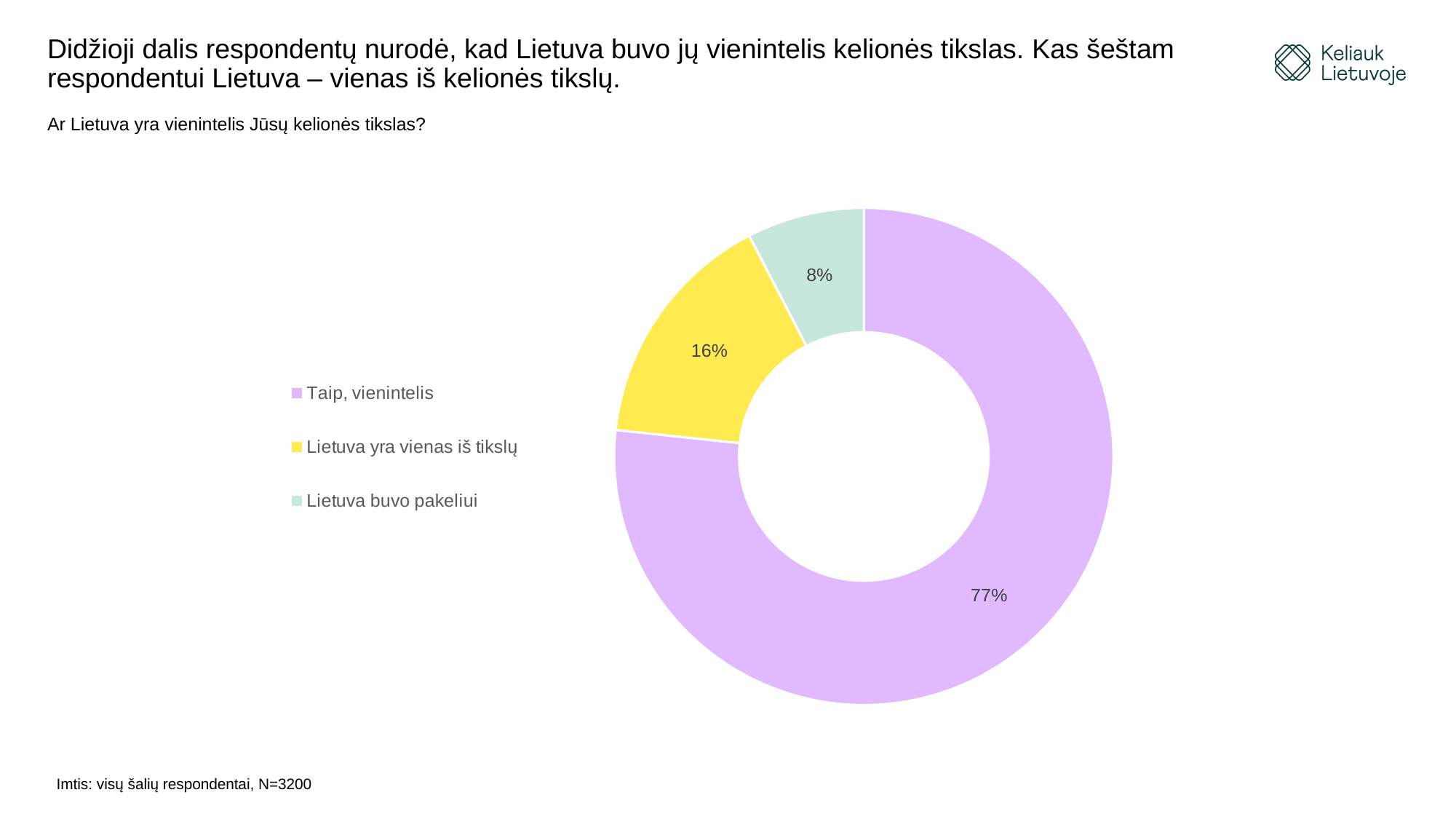
What share of respondents answered "Taip, vienintelis"? 77% Which answer category has the largest share? Taip, vienintelis What share of respondents answered "Lietuva buvo pakeliui"? 8% Which answer category has the smallest share? Lietuva buvo pakeliui What share of respondents answered "Lietuva yra vienas iš tikslų"? 16% What colour is the slice for "Lietuva yra vienas iš tikslų"? Yellow What is the sample size stated on the slide? N=3200 What is the difference in percentage points between "Taip, vienintelis" and "Lietuva yra vienas iš tikslų"? 61 percentage points What is the difference in percentage points between "Lietuva yra vienas iš tikslų" and "Lietuva buvo pakeliui"? 8 percentage points Which is larger: the share for "Lietuva yra vienas iš tikslų" or for "Lietuva buvo pakeliui"? Lietuva yra vienas iš tikslų How many categories does the chart show? 3 What kind of chart is shown on the slide? Pie chart (doughnut)